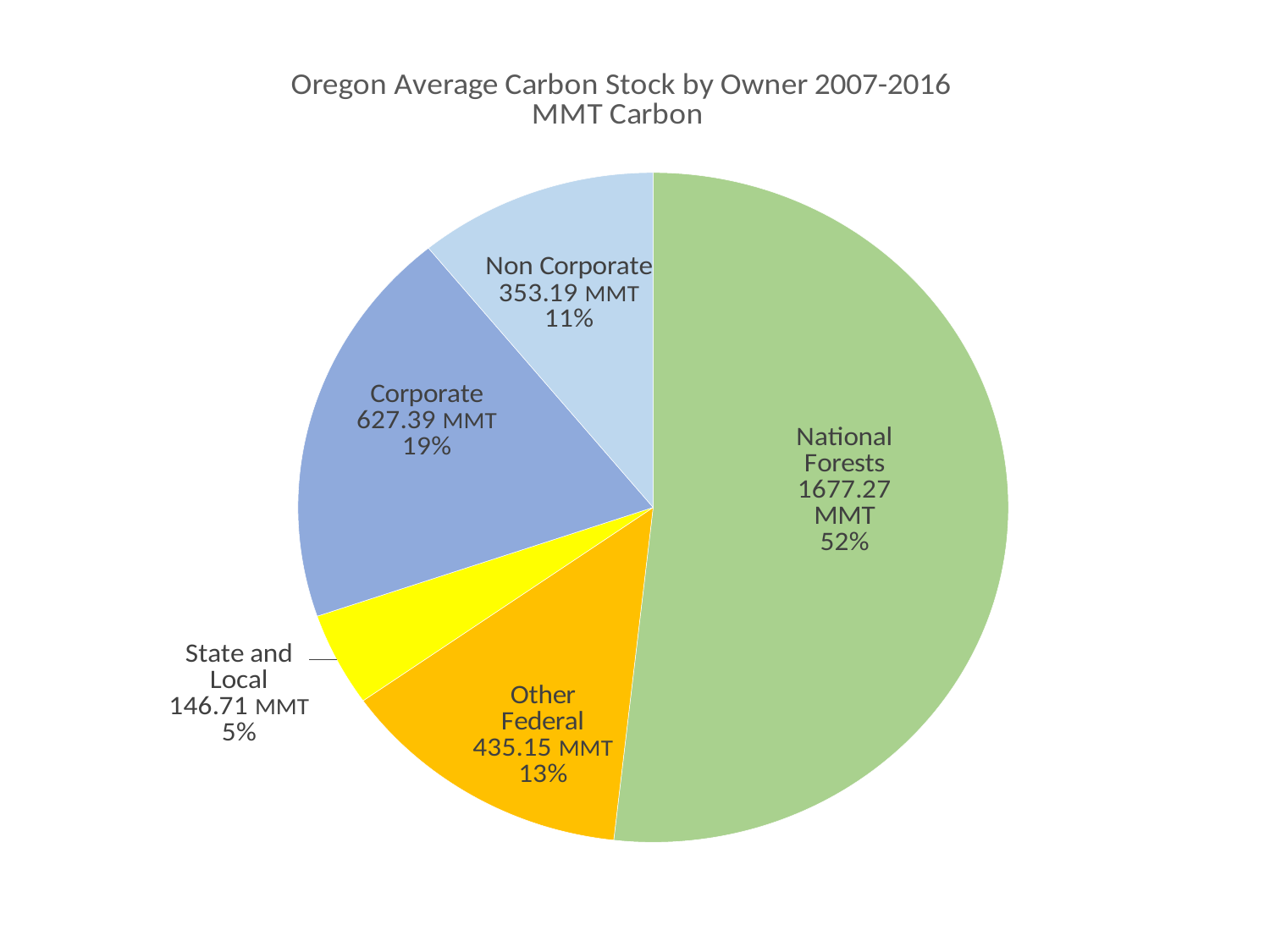
Which owner category has the largest carbon stock? National Forests What share of the total carbon stock is held by National Forests? 52% What is the difference in carbon stock between Corporate and Non Corporate owners? 274.20 MMT What share of the total carbon stock is held by Non Corporate owners? 11% What is the average carbon stock for State and Local owners? 146.71 MMT Which owner category has the smallest carbon stock? State and Local Which has a larger carbon stock, Other Federal or Corporate? Corporate What is the average carbon stock for National Forests? 1677.27 MMT What is the average carbon stock for Corporate owners? 627.39 MMT What type of chart is shown on the slide? Pie chart What is the average carbon stock for Other Federal owners? 435.15 MMT How many owner categories are shown in the pie chart? 5